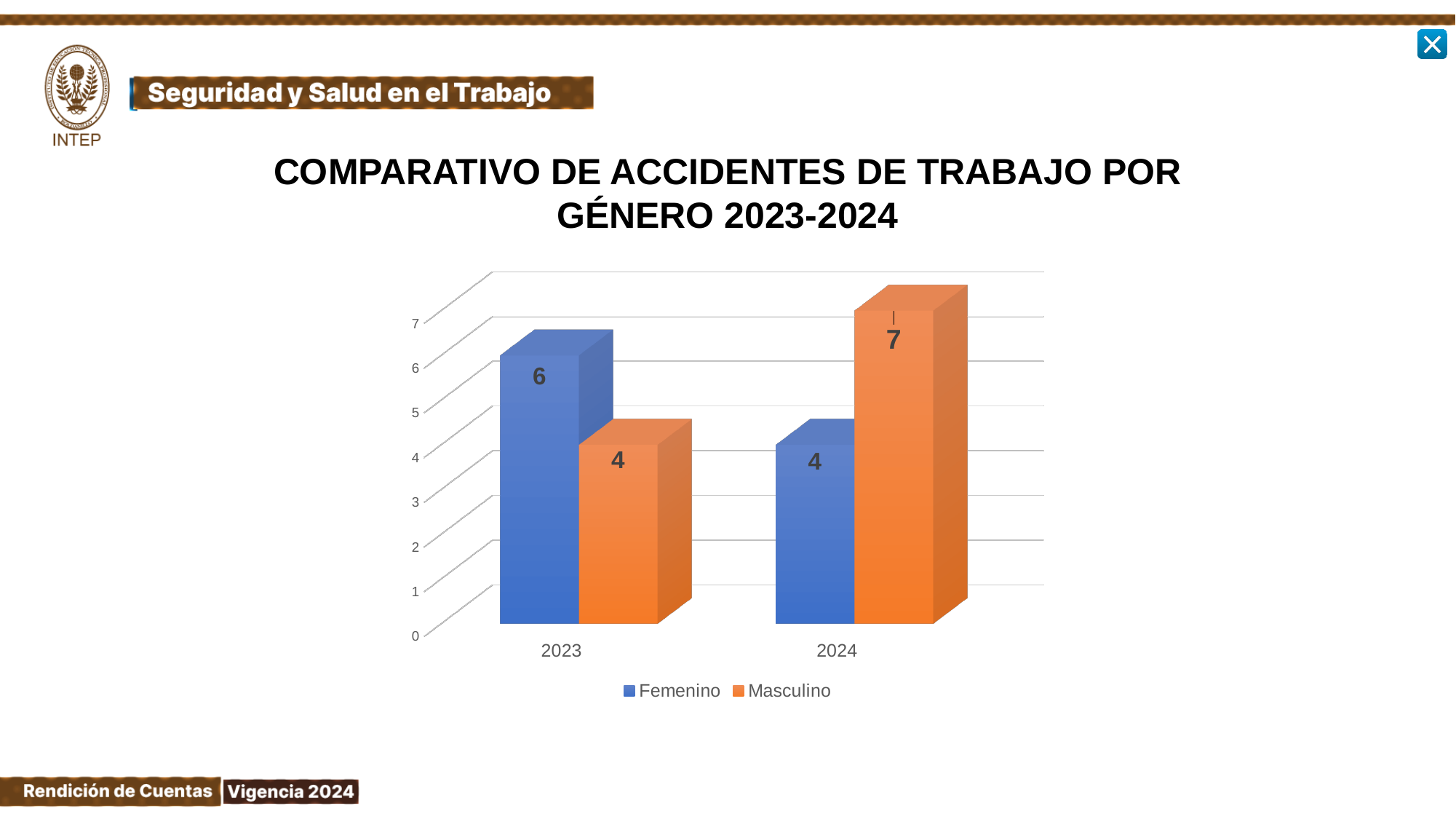
What is the difference between the Masculino value in 2024 and the Masculino value in 2023? 3 Does the Masculino value rise or fall from 2023 to 2024? Rise Which is larger: Femenino in 2023 or Femenino in 2024? Femenino in 2023 How many years are shown on the x axis? 2 Which series has the highest value in 2024? Masculino How many series does the legend list? 2 What is the value for Masculino in 2023? 4 What is the value for Femenino in 2024? 4 Which series has the lowest value in 2023? Masculino What is the value for Masculino in 2024? 7 What kind of chart is shown on the slide? Bar chart What is the value for Femenino in 2023? 6